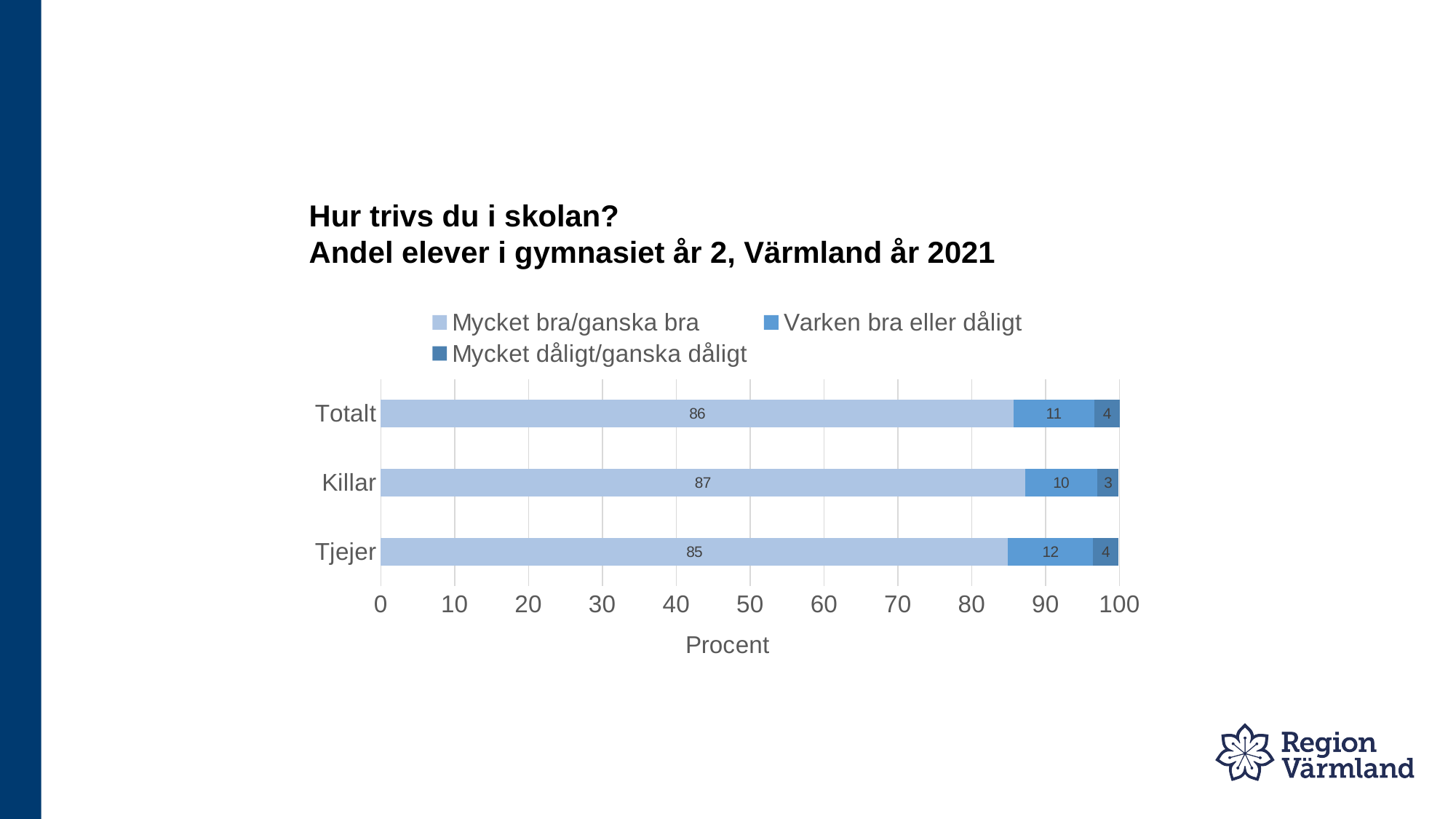
What is the total of the stacked bar for Totalt? 101 Which is larger: the "Varken bra eller dåligt" value for Tjejer or for Totalt? Tjejer What kind of chart is shown? Stacked bar chart What is the value for "Mycket dåligt/ganska dåligt" for Killar? 3 What is the value for "Mycket bra/ganska bra" for Totalt? 86 Which category has the lowest value for "Varken bra eller dåligt"? Killar Which category has the highest value for "Mycket bra/ganska bra"? Killar What is the value for "Varken bra eller dåligt" for Tjejer? 12 How many series does the legend list? 3 What is the difference between the "Mycket bra/ganska bra" values for Killar and Tjejer? 2 What is the label of the x axis? Procent How many categories are shown on the y axis? 3